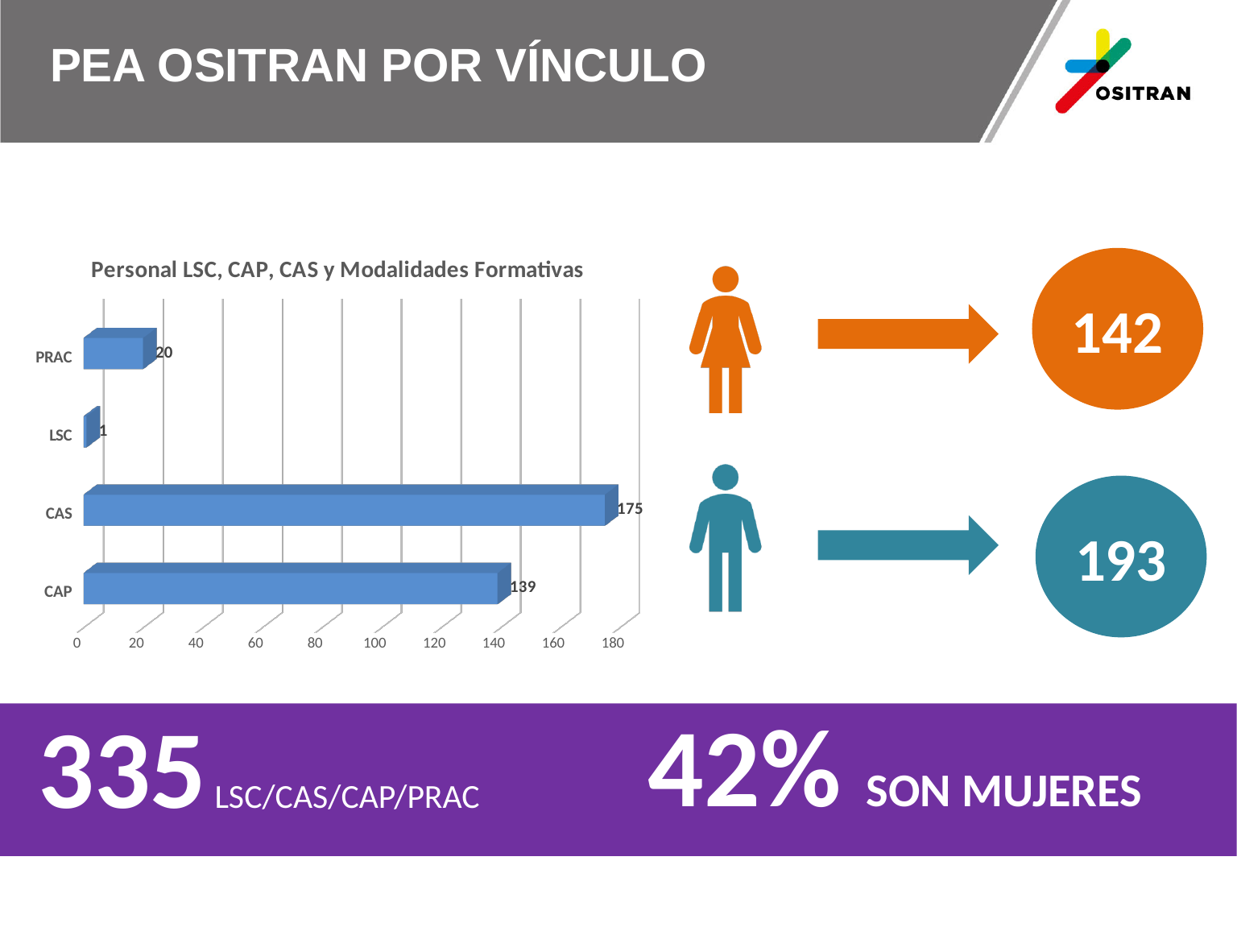
How many categories are shown in the chart? 4 Which category has the lowest value in the chart? LSC What is the value for CAP in the chart? 139 Which category has the highest value in the chart? CAS What is the difference between the values for CAS and CAP? 36 Which is larger, the value for PRAC or the value for LSC? PRAC What is the value for PRAC in the chart? 20 Is the value for CAP greater or less than 120? greater What is the value for CAS in the chart? 175 What kind of chart is shown on the slide? bar chart What is the title of the chart? Personal LSC, CAP, CAS y Modalidades Formativas What is the value for LSC in the chart? 1